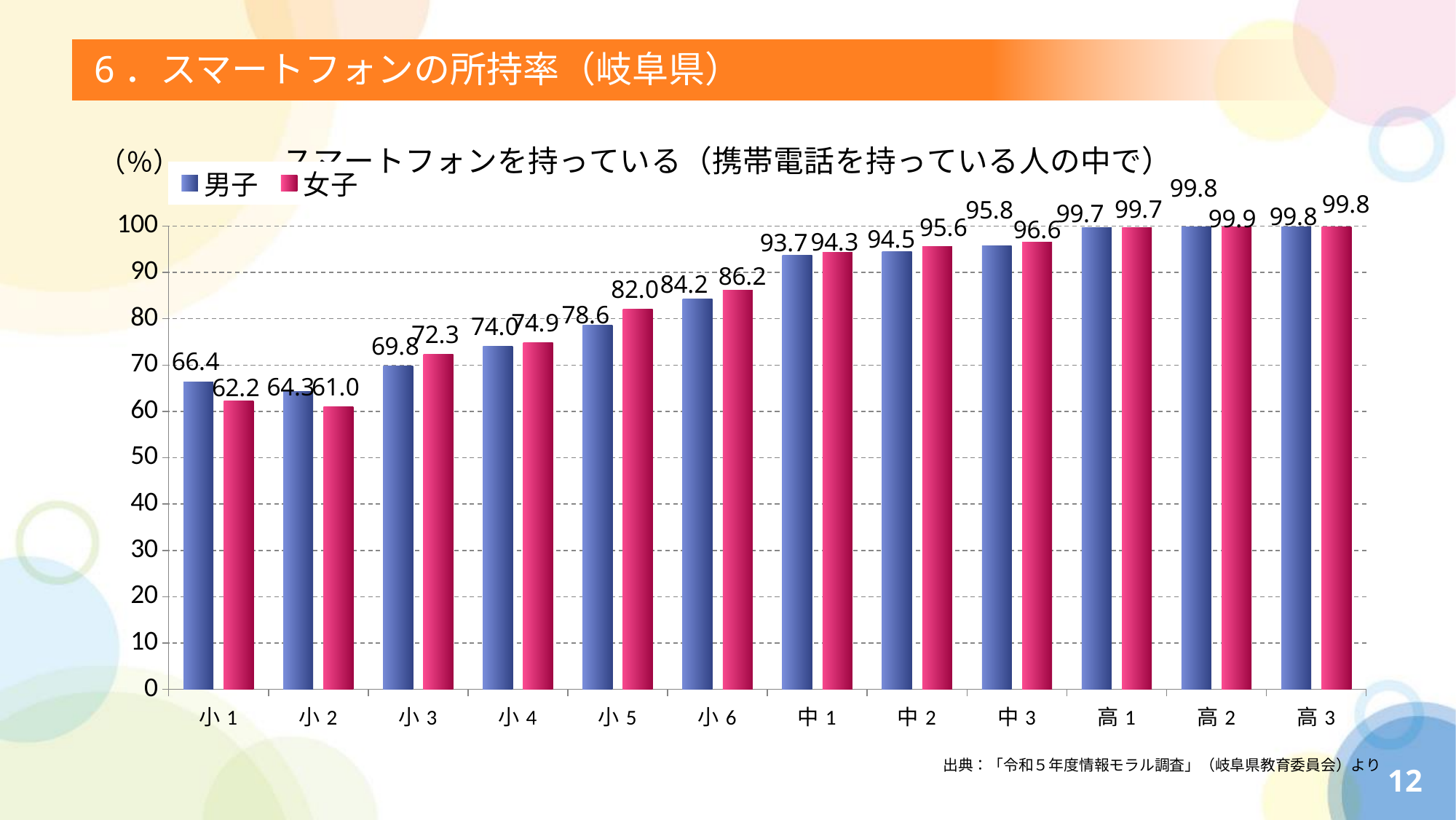
What kind of chart is this? bar chart How many categories are shown on the x axis? 12 What is the difference between the 女子 and 男子 values in 小５? 3.4 What is the value for 男子 in 中３? 95.8 How many series does the legend list? 2 What is the value for 男子 in 小１? 66.4 Do the 女子 values generally rise or fall from 小２ to 高２? rise Is the value for 男子 in 小３ greater or less than 60? greater What is the value for 女子 in 小６? 86.2 Which category has the lowest value for 女子? 小２ In 小１, which is larger, the 男子 value or the 女子 value? 男子 What is the value for 女子 in 高２? 99.9